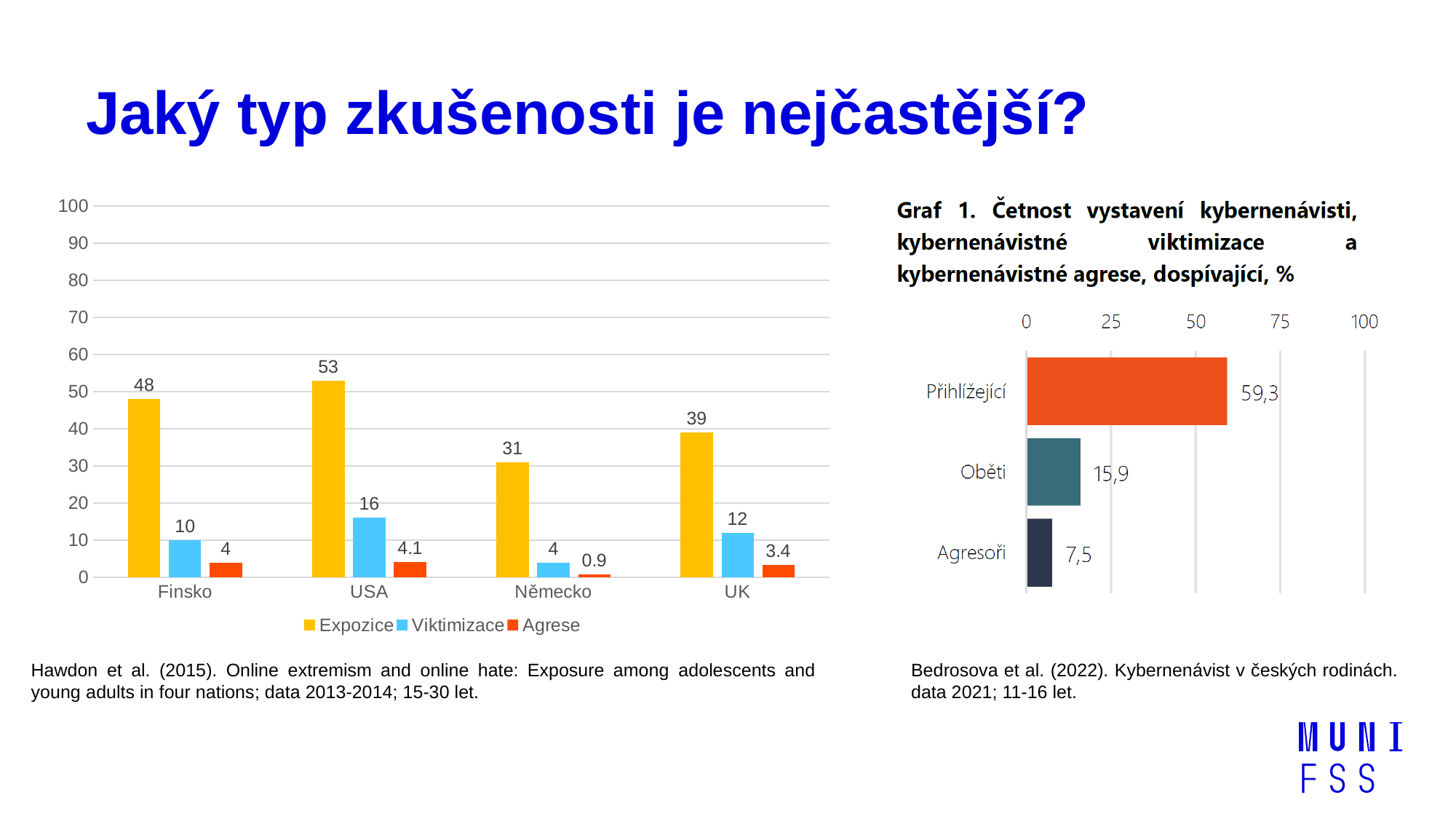
In the left chart, what is the difference between the Expozice values for Finsko and UK? 9 In the right chart (Graf 1), what is the value for Přihlížející? 59,3 In the right chart (Graf 1), which category has the lowest value? Agresoři In the left chart, which is larger: the Viktimizace value for USA or for UK? USA In the left chart, which country has the highest Expozice value? USA In the left chart, what is the Expozice value for USA? 53 In the left chart, how many series does the legend list? 3 In the left chart, how many countries are shown on the x axis? 4 In the right chart (Graf 1), what is the difference between the values for Oběti and Agresoři? 8,4 In the left chart, which country has the lowest Viktimizace value? Německo In the left chart, what is the Agrese value for Německo? 0.9 What kind of chart is the right chart (Graf 1)? Bar chart